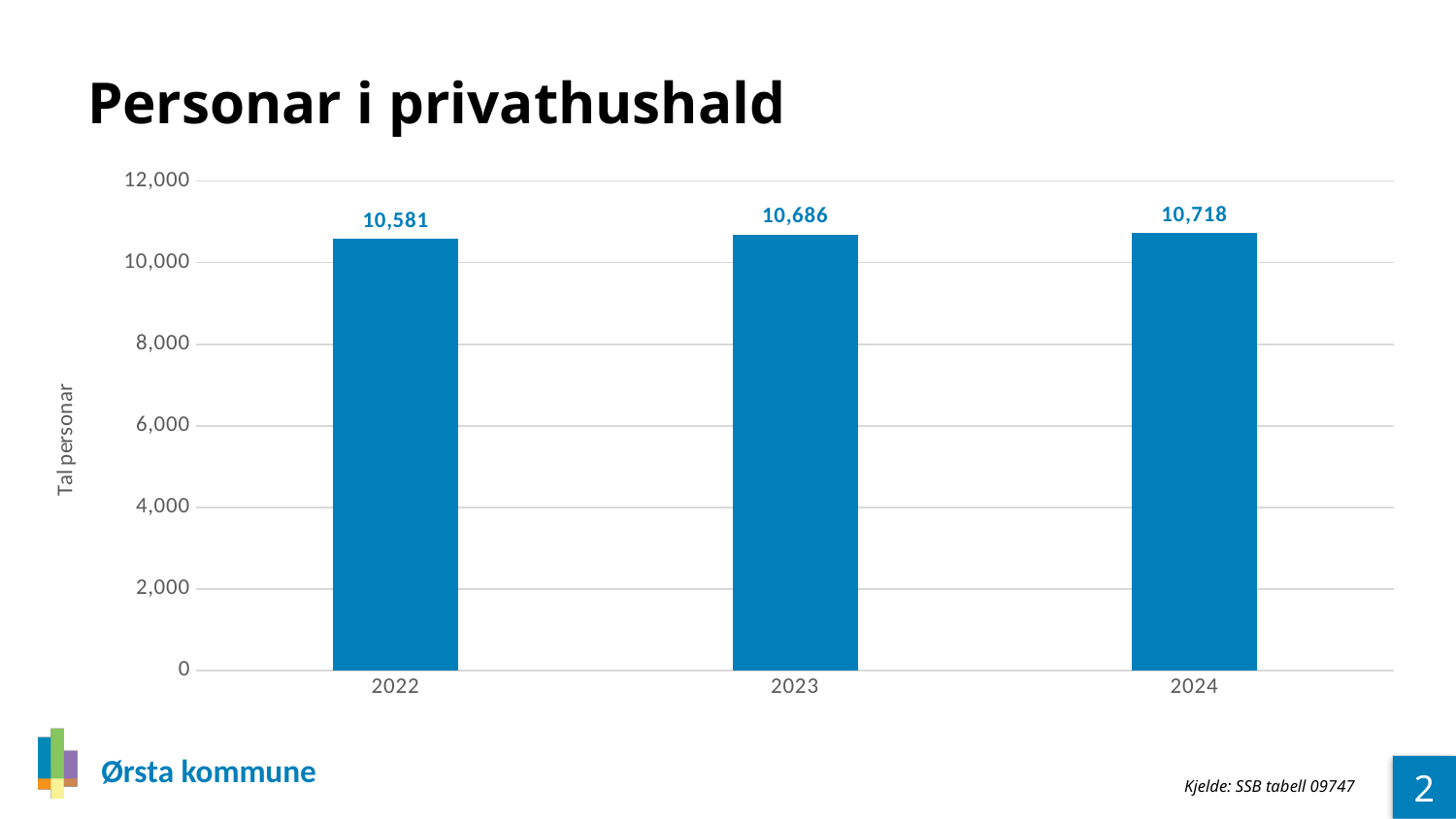
Do the values rise or fall from 2022 to 2024? Rise What is the value for 2023? 10,686 What is the value for 2022? 10,581 What kind of chart is shown on the slide? Bar chart What is the title of the chart? Personar i privathushald Is the value for 2023 greater or less than 10,000? greater What is the difference between the values for 2024 and 2022? 137 Which year has the lowest value? 2022 What is the value for 2024? 10,718 How many years are shown on the x axis? 3 Which year has the highest value? 2024 What is the difference between the values for 2023 and 2022? 105